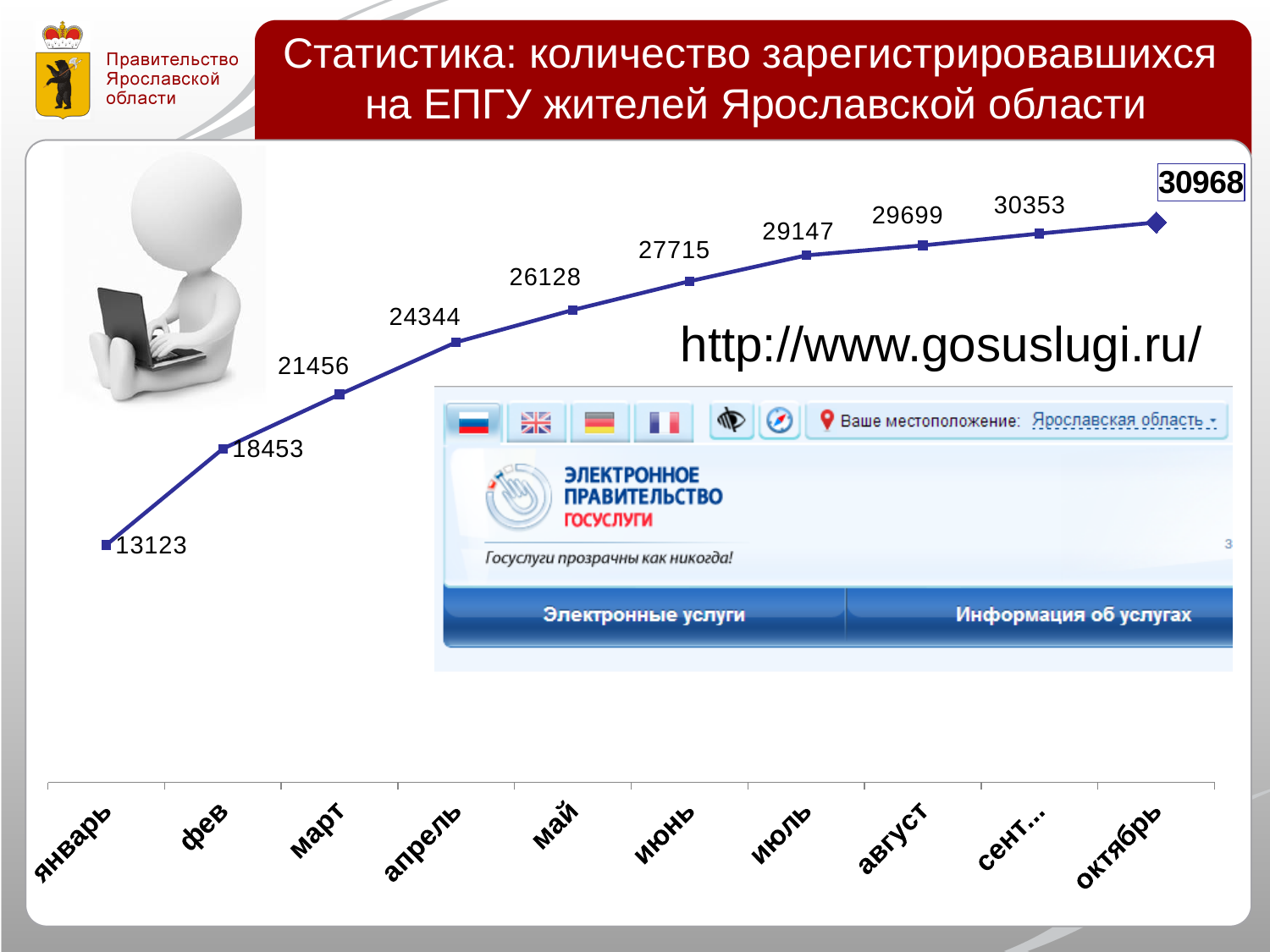
What is the difference between the values for март and фев? 3003 Which is larger, the value for май or the value for июнь? июнь What type of chart is shown on the slide? line chart Do the values rise or fall from январь to октябрь? rise What is the value for апрель? 24344 How many data points are plotted on the chart? 10 Which month has the highest value? октябрь Which month has the lowest value? январь What is the value for октябрь? 30968 What is the value for январь? 13123 What is the value for июль? 29147 What is the difference between the values for октябрь and январь? 17845